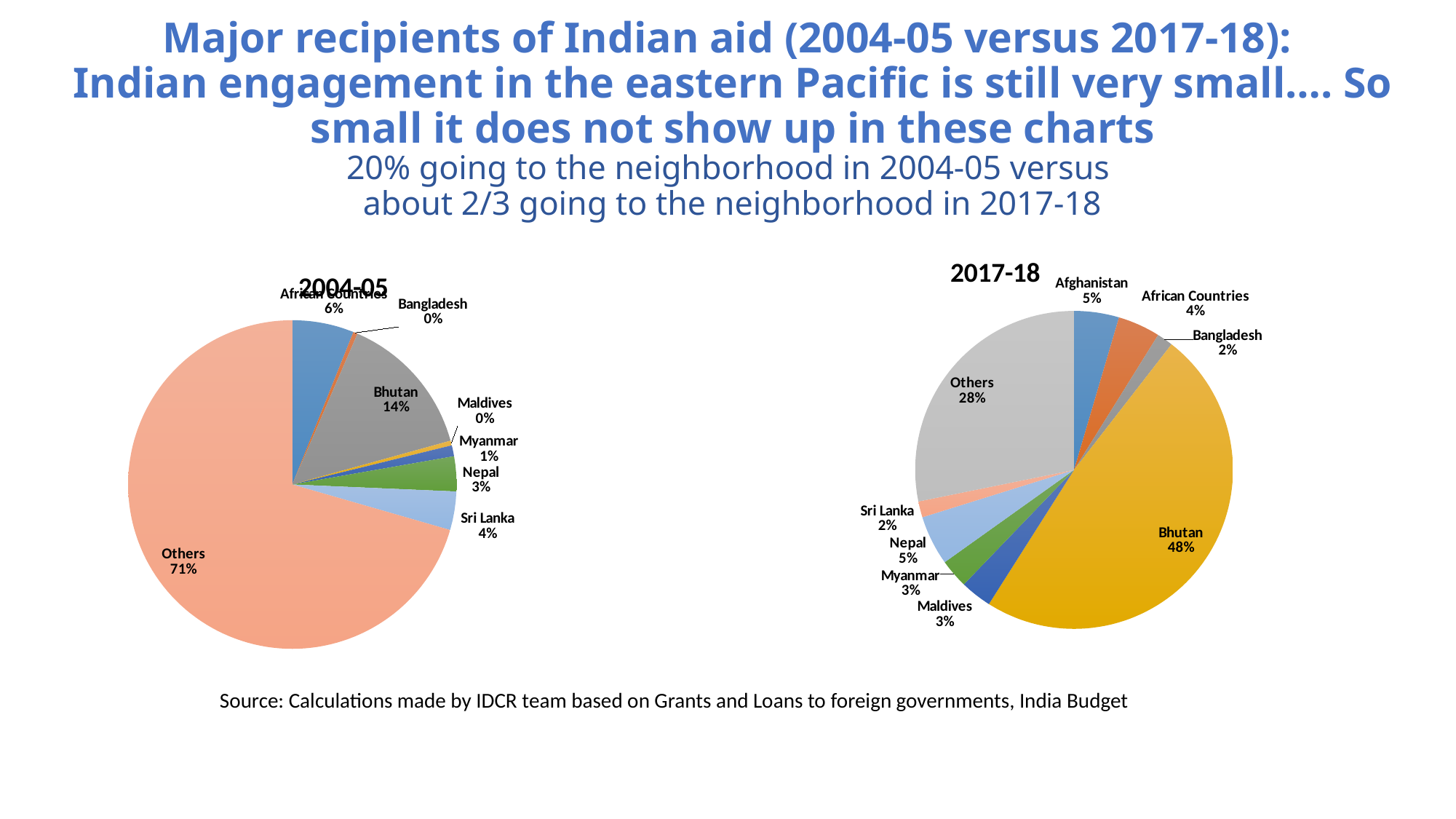
In the 2004-05 pie chart, which category has the largest slice? Others What type of chart is used for the 2004-05 data? Pie chart In the 2004-05 pie chart, what share does Bhutan have? 14% What is the difference between Bhutan's share in the 2017-18 pie chart and its share in the 2004-05 pie chart? 34 percentage points In the 2017-18 pie chart, which category has the largest slice? Bhutan In the 2017-18 pie chart, what share does Nepal have? 5% How many slices does the 2017-18 pie chart have? 9 In the 2004-05 pie chart, what share does Others have? 71% In the 2017-18 pie chart, what share does Afghanistan have? 5% In the 2017-18 pie chart, which is larger, Others or Bhutan? Bhutan In the 2004-05 pie chart, which is larger, African Countries or Sri Lanka? African Countries In the 2017-18 pie chart, what share does Bhutan have? 48%